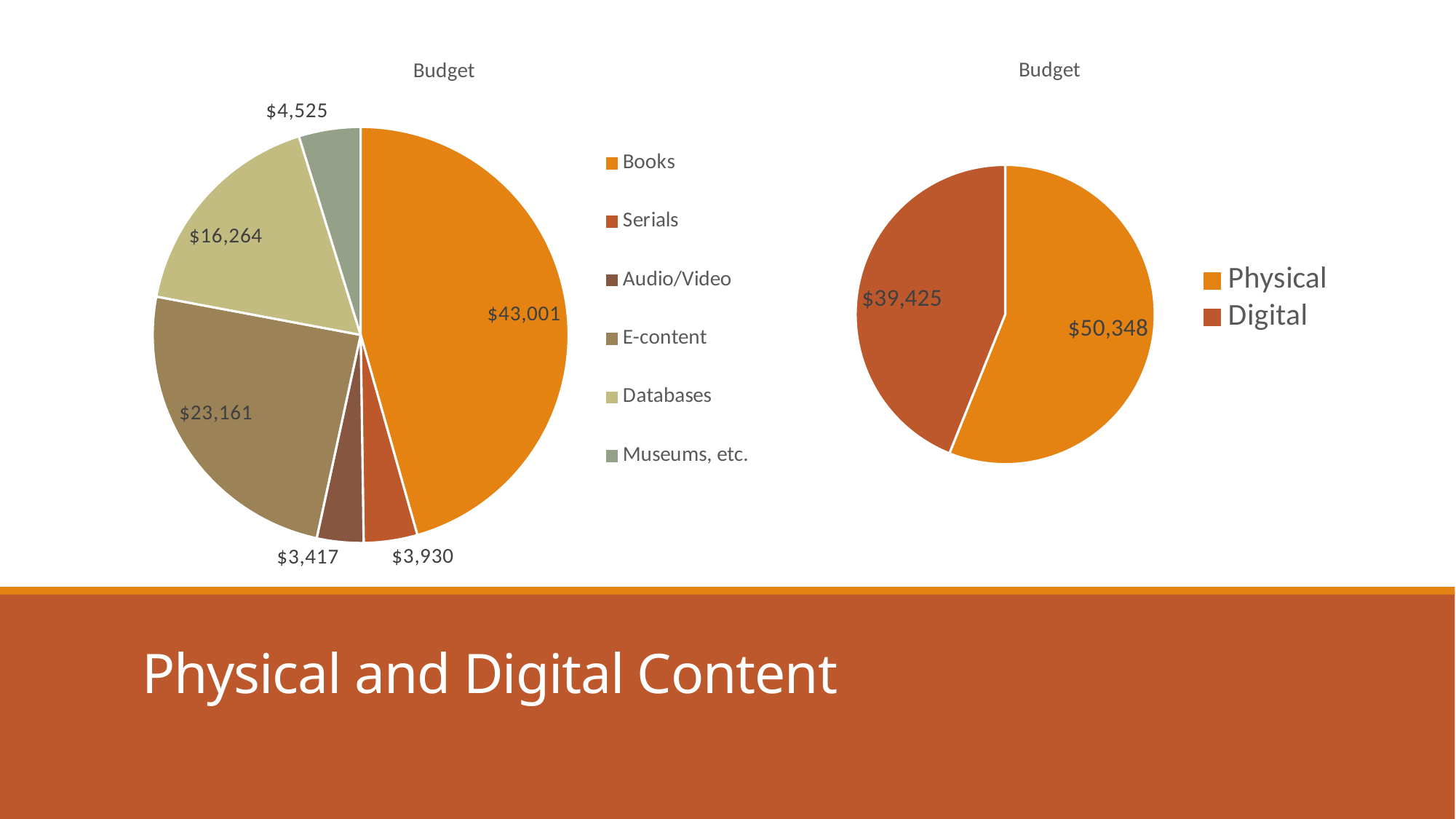
On the left pie chart, which is larger, Databases or E-content? E-content What is the title of the left chart? Budget On the left pie chart, what is the difference between Books and E-content? $19,840 How many categories does the left pie chart show? 6 On the left pie chart, what is the value for Books? $43,001 On the left pie chart, which category has the smallest value? Audio/Video On the left pie chart, what is the value for Museums, etc.? $4,525 On the left pie chart, which category has the largest value? Books On the right pie chart, what is the value for Digital? $39,425 On the left pie chart, what is the value for E-content? $23,161 On the right pie chart, what is the difference between Physical and Digital? $10,923 What kind of chart is the right chart? Pie chart